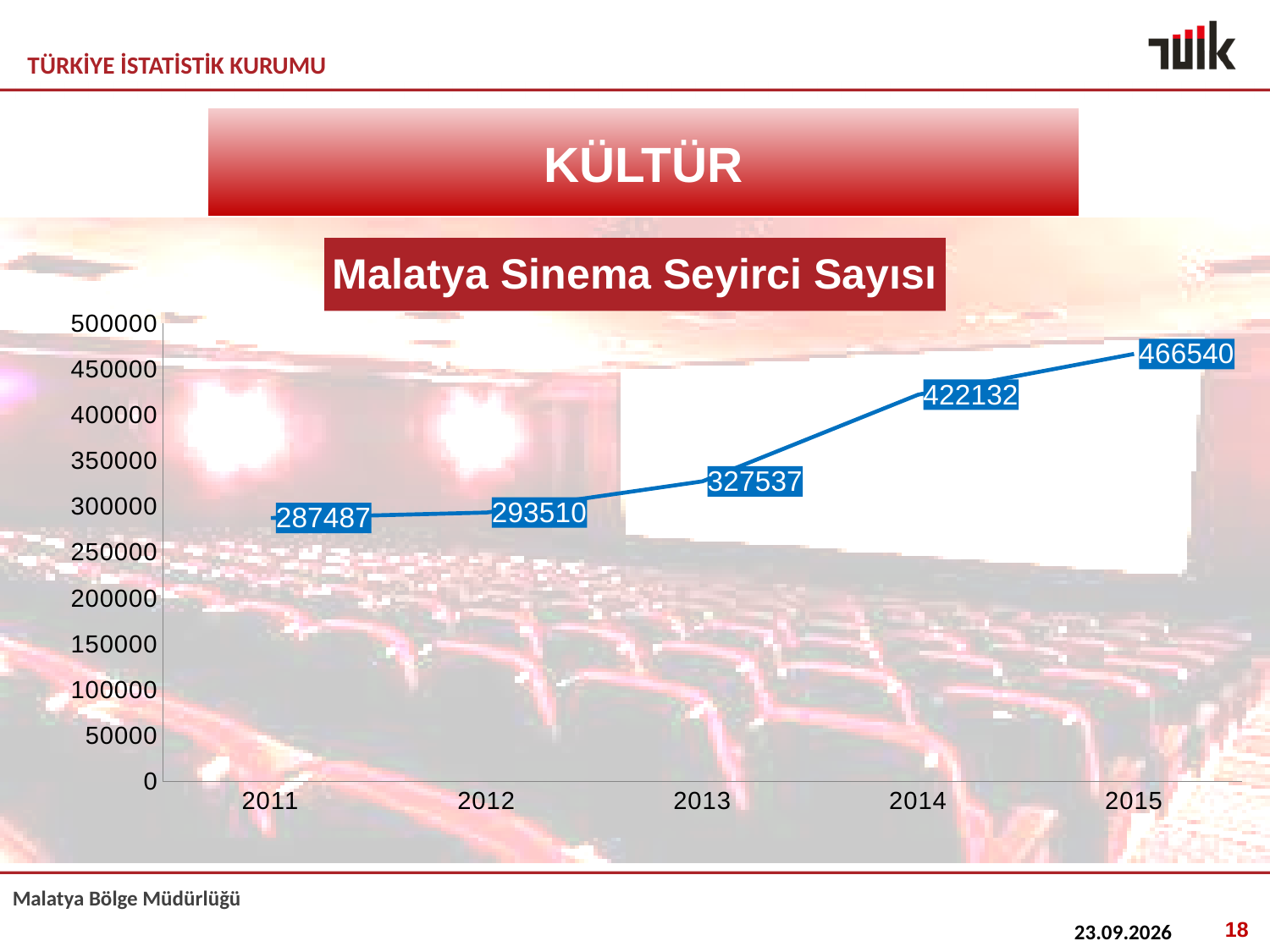
What is the difference between the values for 2015 and 2014 in the Malatya Sinema Seyirci Sayısı chart? 44408 Which is larger in the Malatya Sinema Seyirci Sayısı chart, the value for 2012 or the value for 2014? 2014 What is the value for 2015 in the Malatya Sinema Seyirci Sayısı chart? 466540 What kind of chart is the Malatya Sinema Seyirci Sayısı chart? line chart What is the value for 2013 in the Malatya Sinema Seyirci Sayısı chart? 327537 Do the values in the Malatya Sinema Seyirci Sayısı chart rise or fall from 2011 to 2015? rise What is the difference between the values for 2014 and 2013 in the Malatya Sinema Seyirci Sayısı chart? 94595 What is the value for 2011 in the Malatya Sinema Seyirci Sayısı chart? 287487 How many years are plotted in the Malatya Sinema Seyirci Sayısı chart? 5 Which year has the lowest value in the Malatya Sinema Seyirci Sayısı chart? 2011 Is the value for 2014 in the Malatya Sinema Seyirci Sayısı chart greater or less than 400000? greater Which year has the highest value in the Malatya Sinema Seyirci Sayısı chart? 2015